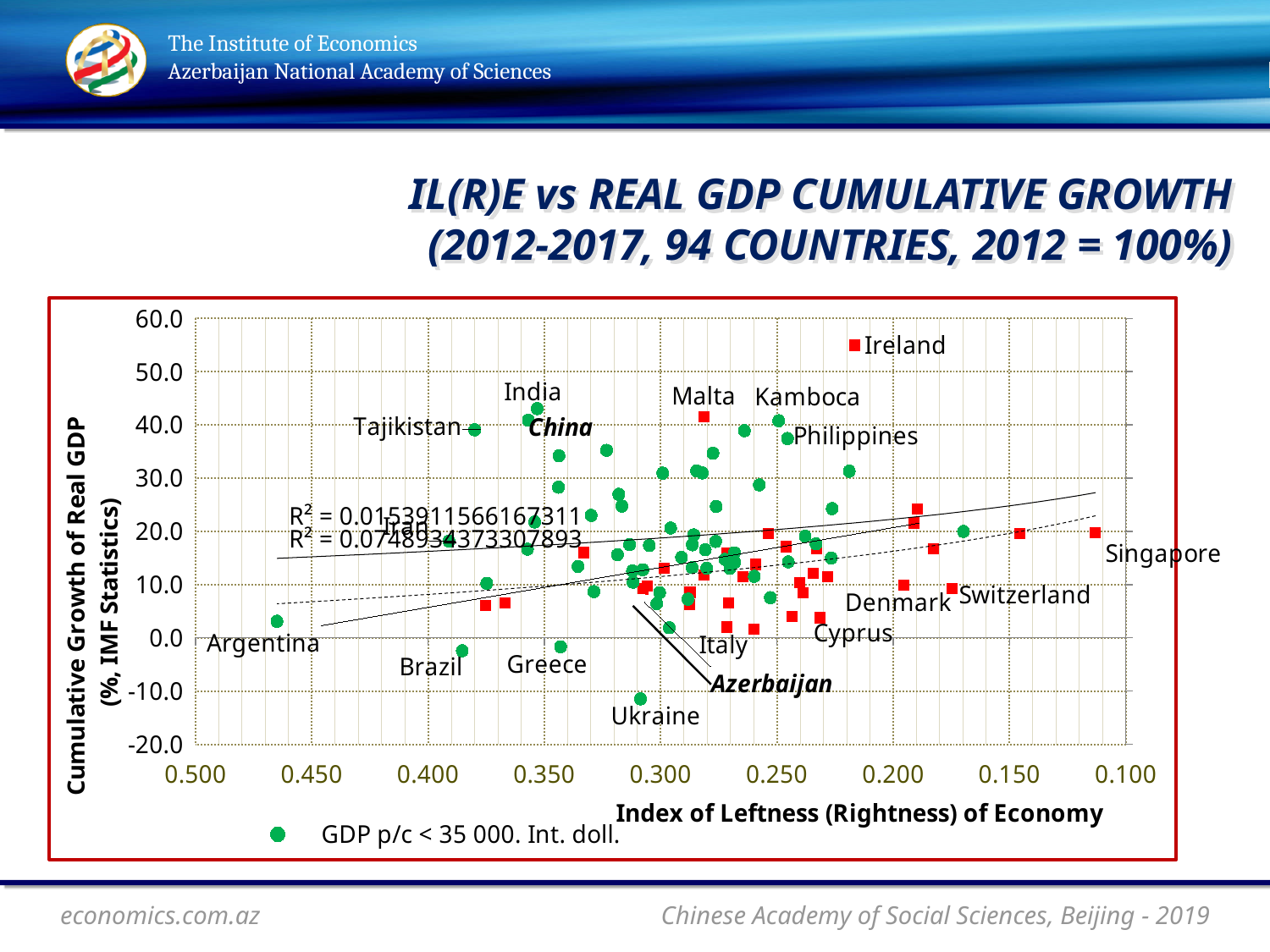
Is the cumulative growth of real GDP for Brazil greater or less than 0.0? less Is the cumulative growth of real GDP for Ireland greater or less than 50.0? greater Which labelled country has the highest cumulative growth of real GDP on the chart? Ireland What is the label of the x axis of the chart? Index of Leftness (Rightness) of Economy Which has a higher cumulative growth of real GDP, Ireland or Singapore? Ireland What kind of chart is shown on the slide? Scatter chart Which labelled country has the lowest cumulative growth of real GDP on the chart? Ukraine Which has a higher cumulative growth of real GDP, Argentina or Ukraine? Argentina According to the chart title, how many countries are plotted? 94 Is the cumulative growth of real GDP for Cyprus greater or less than 10.0? less What does the legend entry with the green circle marker say? GDP p/c < 35 000. Int. doll.